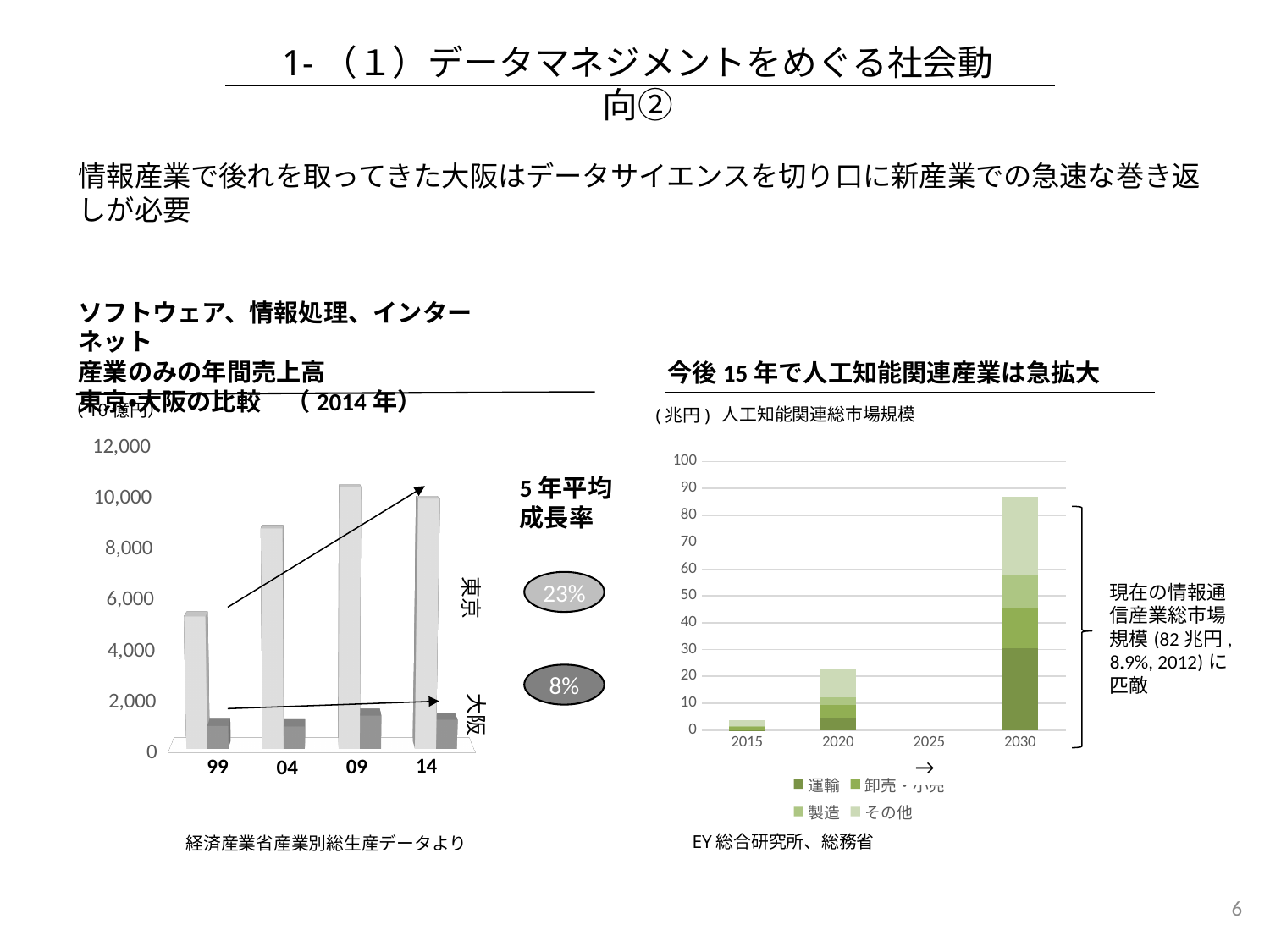
In the left chart, what 5-year average growth rate (5年平均成長率) is shown for 大阪? 8% In the left chart, which year has the lowest value for 東京? 99 In the left chart, is the value for 大阪 in 14 greater or less than 2,000? less How many series does the legend of the right chart (人工知能関連総市場規模) list? 4 What kind of chart is the left chart comparing 東京 and 大阪? bar chart In the right chart (人工知能関連総市場規模), is the total for 2030 greater or less than 80? greater In the left chart, what 5-year average growth rate (5年平均成長率) is shown for 東京? 23% In the right chart (人工知能関連総市場規模), which year has the highest total? 2030 In the left chart, which is larger in 14, 東京 or 大阪? 東京 In the left chart, is the value for 東京 in 99 greater or less than 4,000? greater In the right chart (人工知能関連総市場規模), do the totals rise or fall from 2015 to 2030? rise How many years are shown on the x axis of the left chart? 4